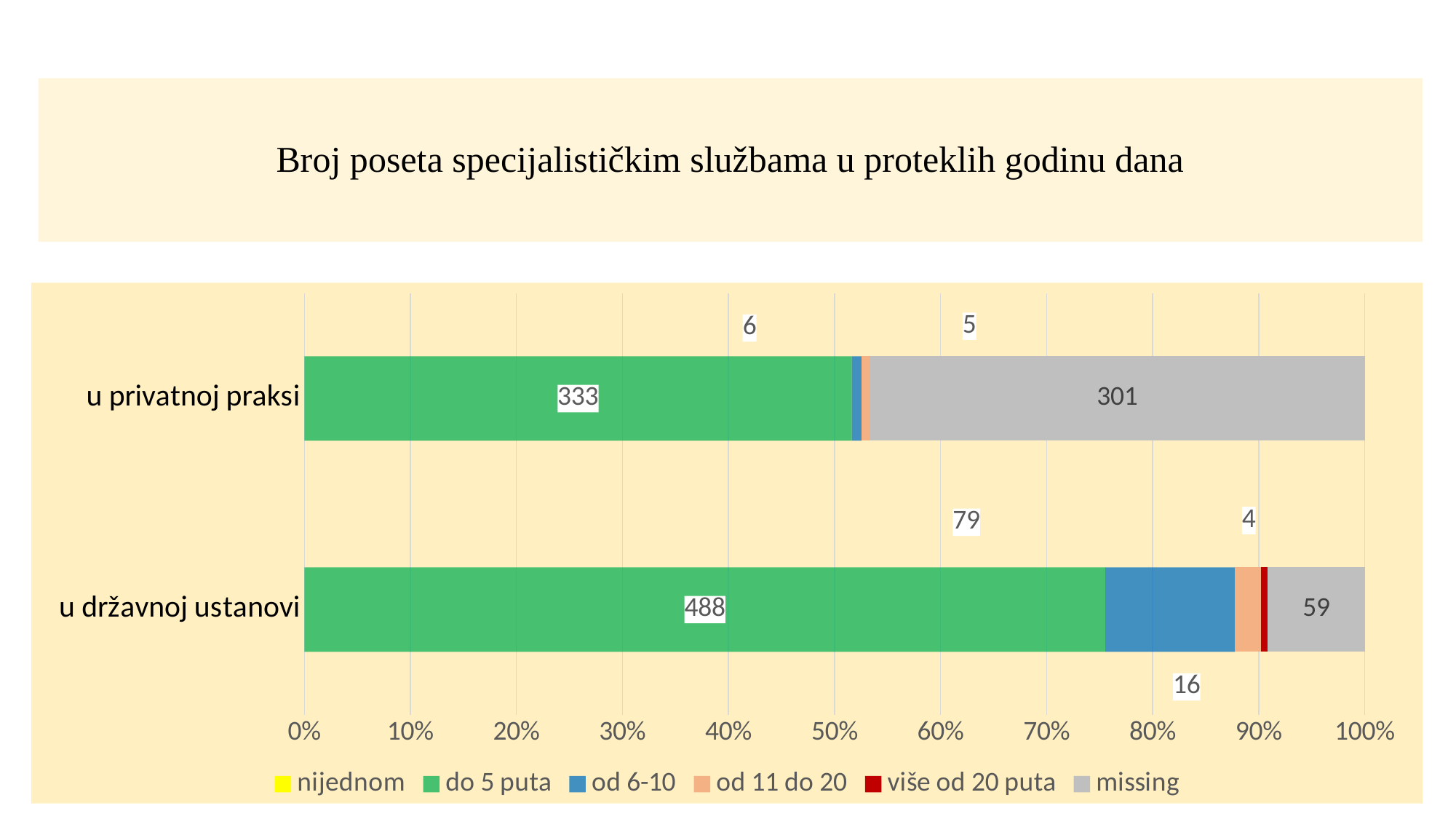
What is the value of 'missing' for 'u privatnoj praksi'? 301 What kind of chart is shown on the slide? Stacked bar chart What is the value of 'do 5 puta' for 'u državnoj ustanovi'? 488 How many series does the legend list? 6 What is the value of 'do 5 puta' for 'u privatnoj praksi'? 333 What is the value of 'missing' for 'u državnoj ustanovi'? 59 Which category has the larger 'missing' value, 'u privatnoj praksi' or 'u državnoj ustanovi'? u privatnoj praksi What is the value of 'od 6-10' for 'u državnoj ustanovi'? 79 Is the share of 'do 5 puta' in the 'u državnoj ustanovi' bar greater or less than 70%? greater How many categories are plotted on the vertical axis? 2 What is the difference between the 'do 5 puta' values for 'u državnoj ustanovi' and 'u privatnoj praksi'? 155 What is the value of 'više od 20 puta' for 'u državnoj ustanovi'? 4